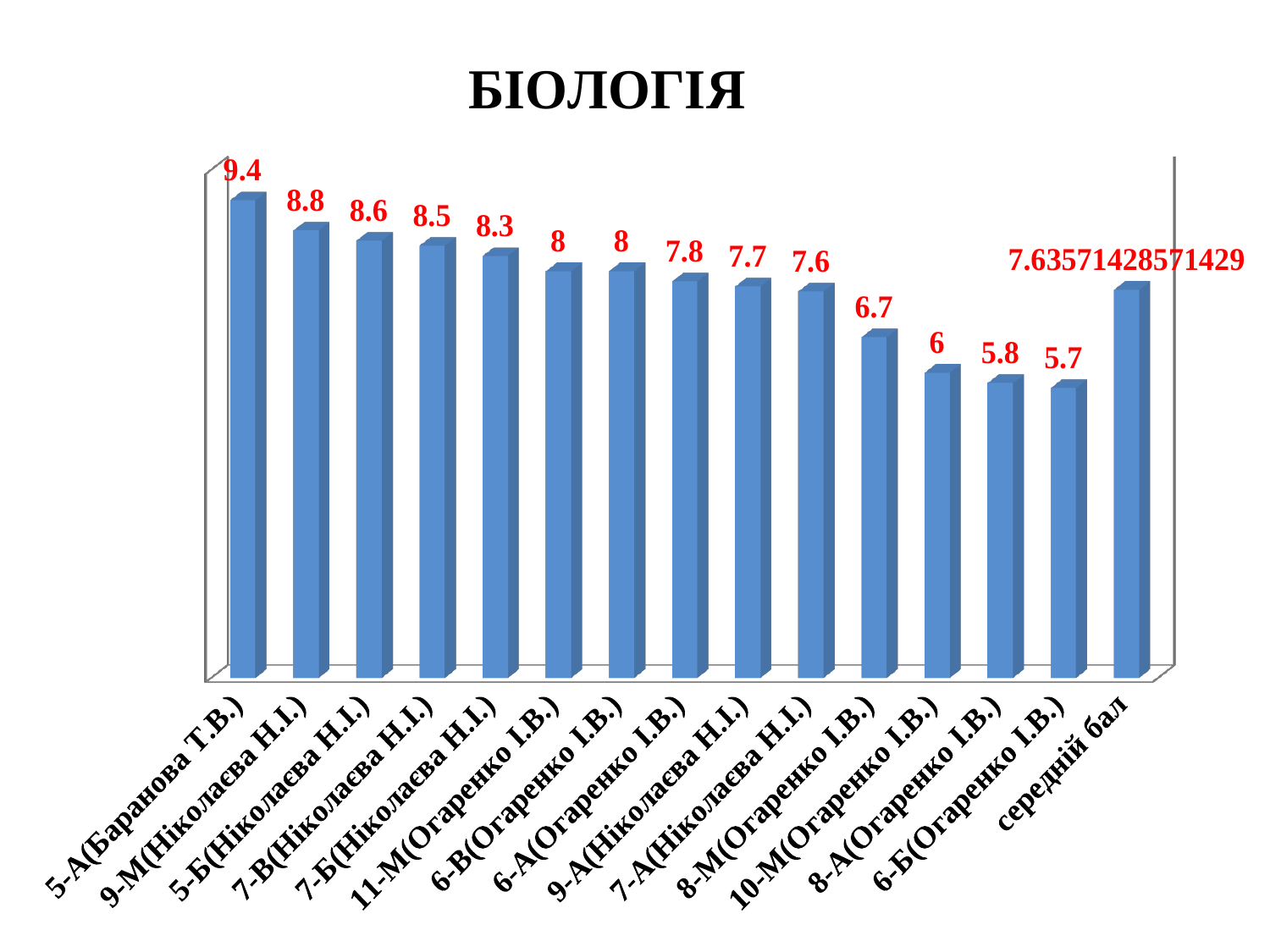
Which is larger, the value for 5-Б(Ніколаєва Н.І.) or the value for 9-А(Ніколаєва Н.І.)? 5-Б(Ніколаєва Н.І.) How many bars are shown in the chart? 15 What is the difference between the values for 9-М(Ніколаєва Н.І.) and 10-М(Огаренко І.В.)? 2.8 What is the value for 5-А(Баранова Т.В.)? 9.4 What value is shown for середній бал? 7.63571428571429 Which category has the highest value? 5-А(Баранова Т.В.) What is the difference between the values for 6-А(Огаренко І.В.) and 7-А(Ніколаєва Н.І.)? 0.2 What is the value for 7-Б(Ніколаєва Н.І.)? 8.3 What kind of chart is shown on the slide? Bar chart What is the value for 8-М(Огаренко І.В.)? 6.7 Which category has the lowest value? 6-Б(Огаренко І.В.) What is the title of the chart? БІОЛОГІЯ